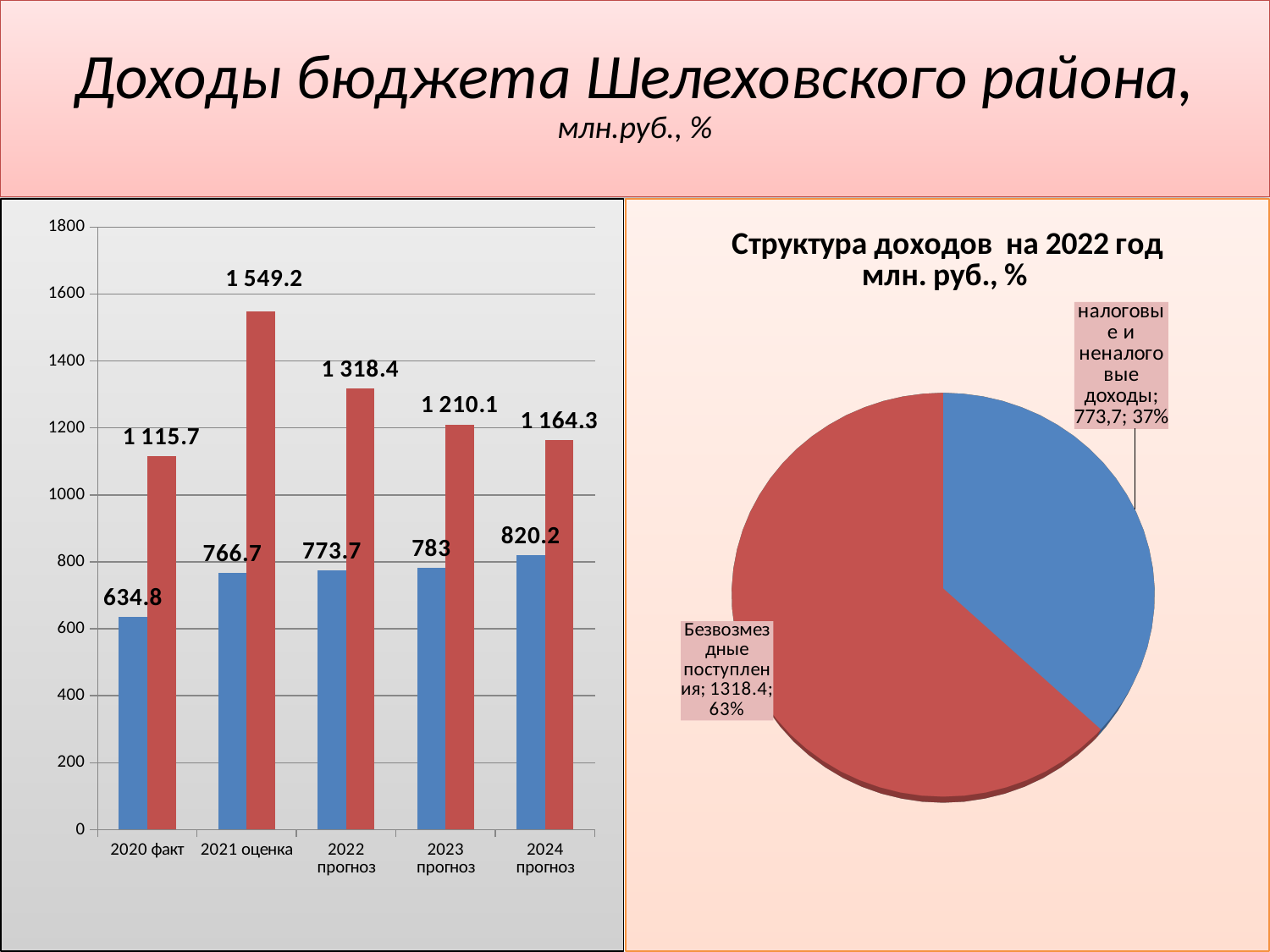
How many categories are shown on the x axis of the bar chart on the left? 5 In the bar chart on the left, what is the value of the blue bar for 2020 факт? 634.8 In the bar chart on the left, which category has the lowest blue bar? 2020 факт In the pie chart 'Структура доходов на 2022 год', what is the value for налоговые и неналоговые доходы? 773,7 In the bar chart on the left, which category has the highest red bar? 2021 оценка In the bar chart on the left, do the blue bars rise or fall from 2020 факт to 2024 прогноз? rise What kind of chart is shown on the left side of the slide? bar chart In the bar chart on the left, which has the larger blue bar: 2023 прогноз or 2024 прогноз? 2024 прогноз In the bar chart on the left, what is the value of the red bar for 2021 оценка? 1 549.2 In the pie chart 'Структура доходов на 2022 год', what share does Безвозмездные поступления have? 63% In the bar chart on the left, is the blue bar for 2021 оценка greater or less than 800? less In the bar chart on the left, what is the difference between the red bar and the blue bar for 2022 прогноз? 544.7